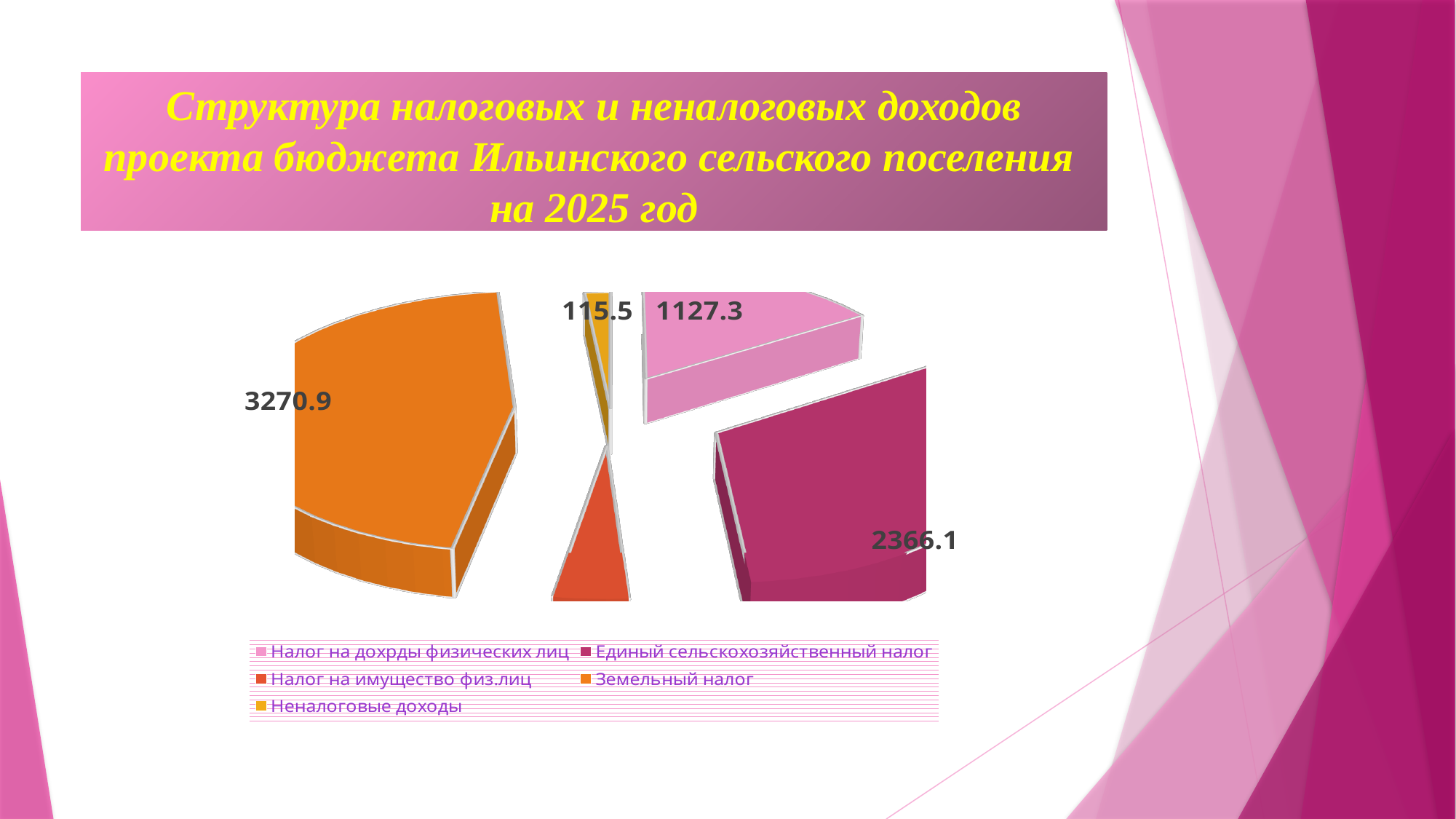
Which is larger: Земельный налог or Единый сельскохозяйственный налог? Земельный налог What is the value for Земельный налог? 3270.9 What is the difference between Единый сельскохозяйственный налог and Налог на доходы физических лиц? 1238.8 Which category has the largest slice of the pie? Земельный налог What type of chart is shown on the slide? Pie chart What is the value for Налог на доходы физических лиц? 1127.3 How many categories does the pie chart have? 5 What colour is the slice for Земельный налог? Orange Which category has the smallest slice of the pie? Неналоговые доходы What is the value for Единый сельскохозяйственный налог? 2366.1 What is the difference between Земельный налог and Единый сельскохозяйственный налог? 904.8 Which year does the slide title say the budget structure refers to? 2025